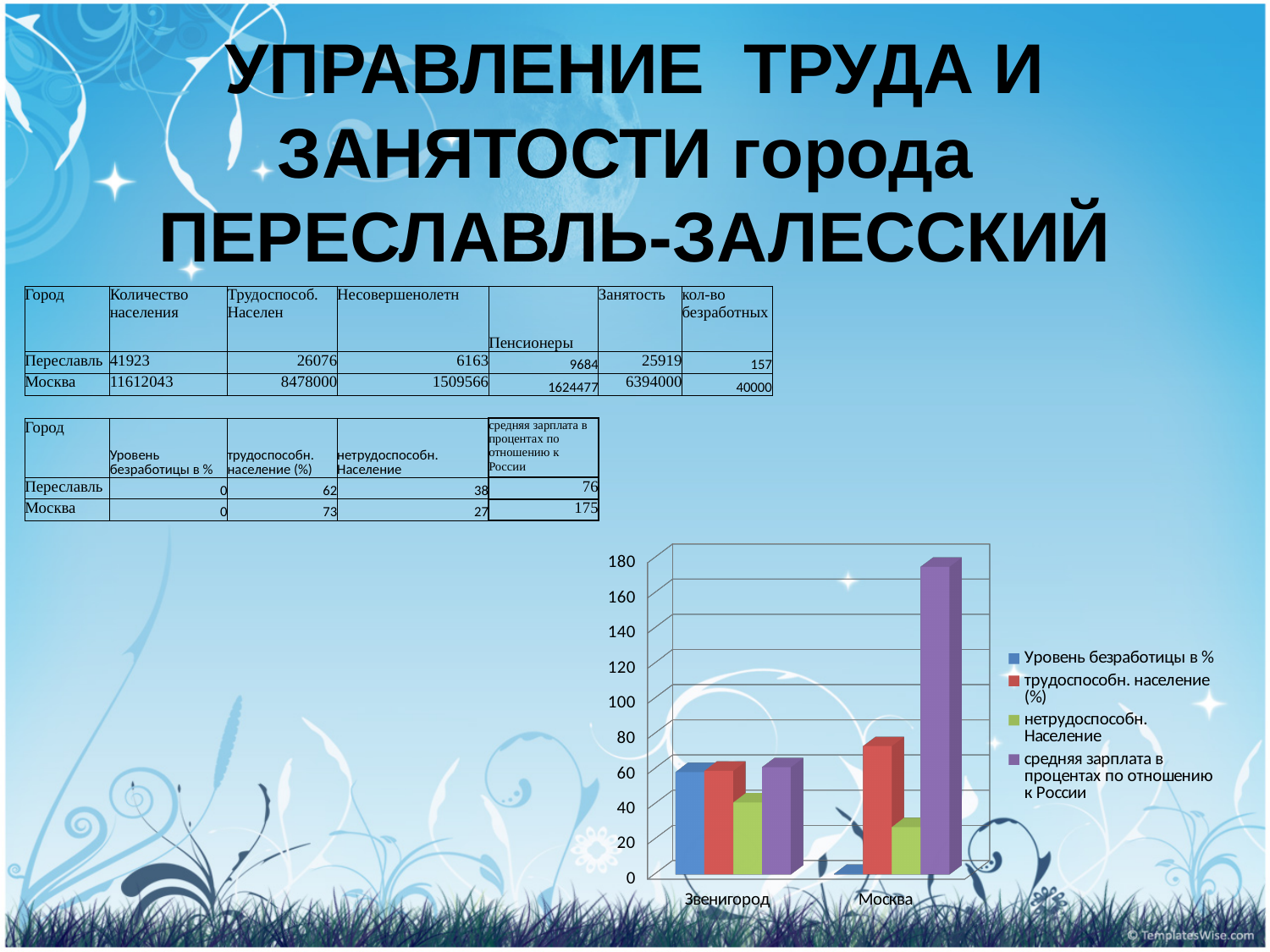
Is the value for 'нетрудоспособн. Население' for Москва greater or less than 40? less Which category has the larger value for 'нетрудоспособн. Население', Звенигород or Москва? Звенигород What colour represents the series 'средняя зарплата в процентах по отношению к России' in the chart? purple Is the value for 'средняя зарплата в процентах по отношению к России' for Москва greater or less than 160? greater How many categories are shown on the x axis of the chart? 2 How many series does the chart legend list? 4 Which category has the taller bar for 'средняя зарплата в процентах по отношению к России'? Москва Is the value for 'Уровень безработицы в %' for Звенигород greater or less than 40? greater Which category has the larger value for 'трудоспособн. население (%)', Звенигород or Москва? Москва Which series has the lowest bar for Москва? Уровень безработицы в % What kind of chart is shown on the slide? bar chart